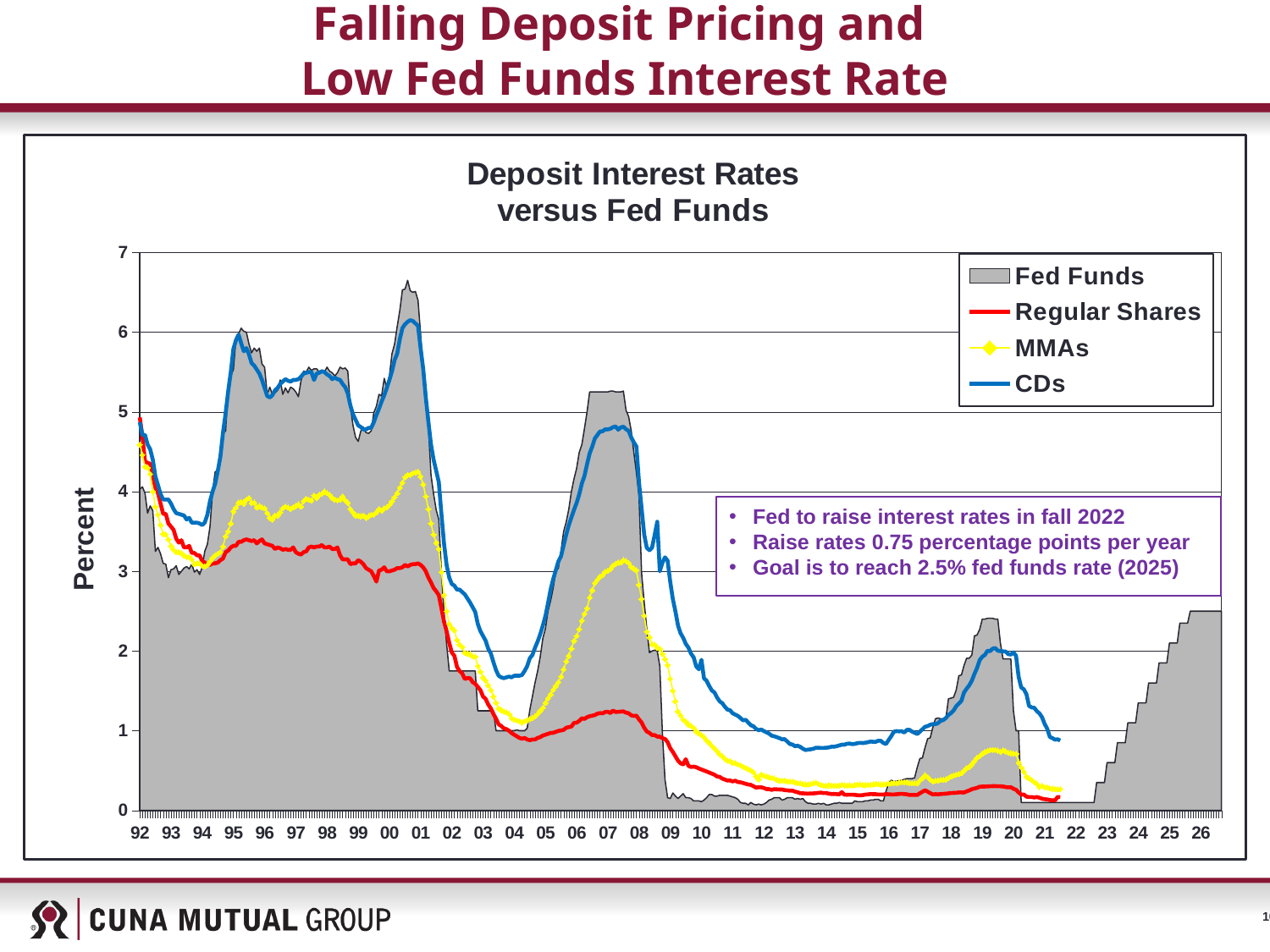
Is the Regular Shares value in 2014 greater or less than 1? less Is the Fed Funds value in 2010 greater or less than 1? less In 2008, which is higher: the MMAs line or the Regular Shares line? MMAs Is the value of the CDs line at its 2001 peak greater or less than 5? greater What is the title of the chart? Deposit Interest Rates versus Fed Funds What is the label on the vertical axis of the chart? Percent What kind of chart is shown on the slide? Line chart (with a shaded area for Fed Funds) How many series does the chart legend list? 4 In 2007, which is higher: the CDs line or the Regular Shares line? CDs Does the Fed Funds series rise or fall from 2022 to 2026? Rise Which series has the highest value around 2007? Fed Funds